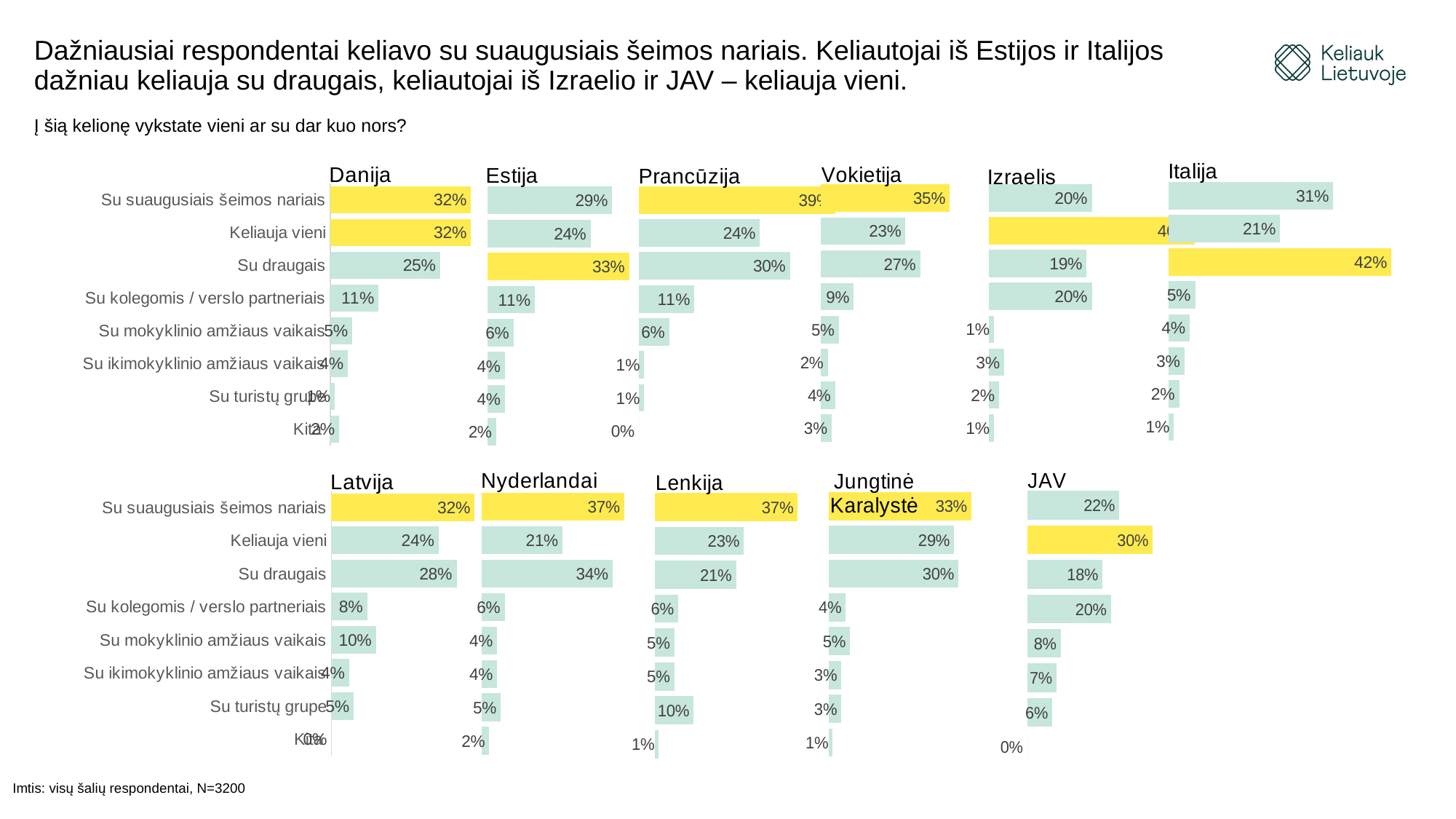
In the Jungtinė Karalystė chart, what is the value for Keliauja vieni? 29% How many countries have their own chart on the slide? 11 In the Nyderlandai chart, which category has the highest value? Su suaugusiais šeimos nariais In the Lenkija chart, what is the value for Su turistų grupe? 10% In the JAV chart, what is the value for Keliauja vieni? 30% In the Danija chart, what is the value for Su kolegomis / verslo partneriais? 11% In the Estija chart, what is the value for Su draugais? 33% In the Latvija chart, which is larger: Keliauja vieni or Su draugais? Su draugais What kind of chart is used for each country on the slide? Bar chart How many categories are shown in each country's chart? 8 In the Vokietija chart, what is the difference between Su suaugusiais šeimos nariais and Su draugais? 8% In the Italija chart, what is the value for Su draugais? 42%